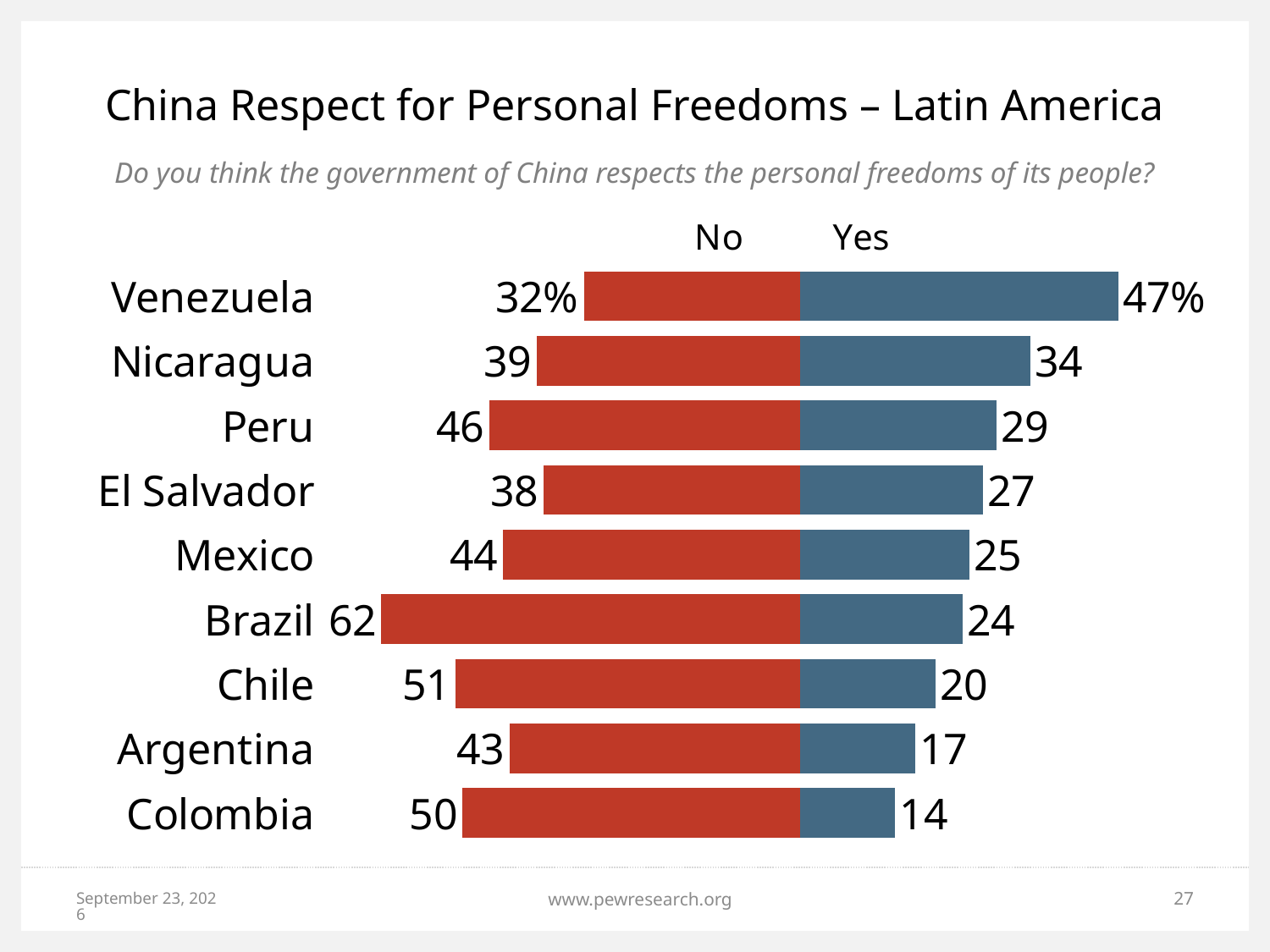
What is the Yes value for Colombia? 14 What percentage of respondents in Venezuela answered Yes? 47% How many series does the chart show? 2 What is the difference between the No and Yes values for Brazil? 38 Which is larger for Chile, the No value or the Yes value? No Which country has the highest No value? Brazil Which country has the lowest No value? Venezuela Which country has the highest Yes value? Venezuela How many countries are shown in the chart? 9 What is the No value for Peru? 46 Which country has the lowest Yes value? Colombia What is the No value for Brazil? 62